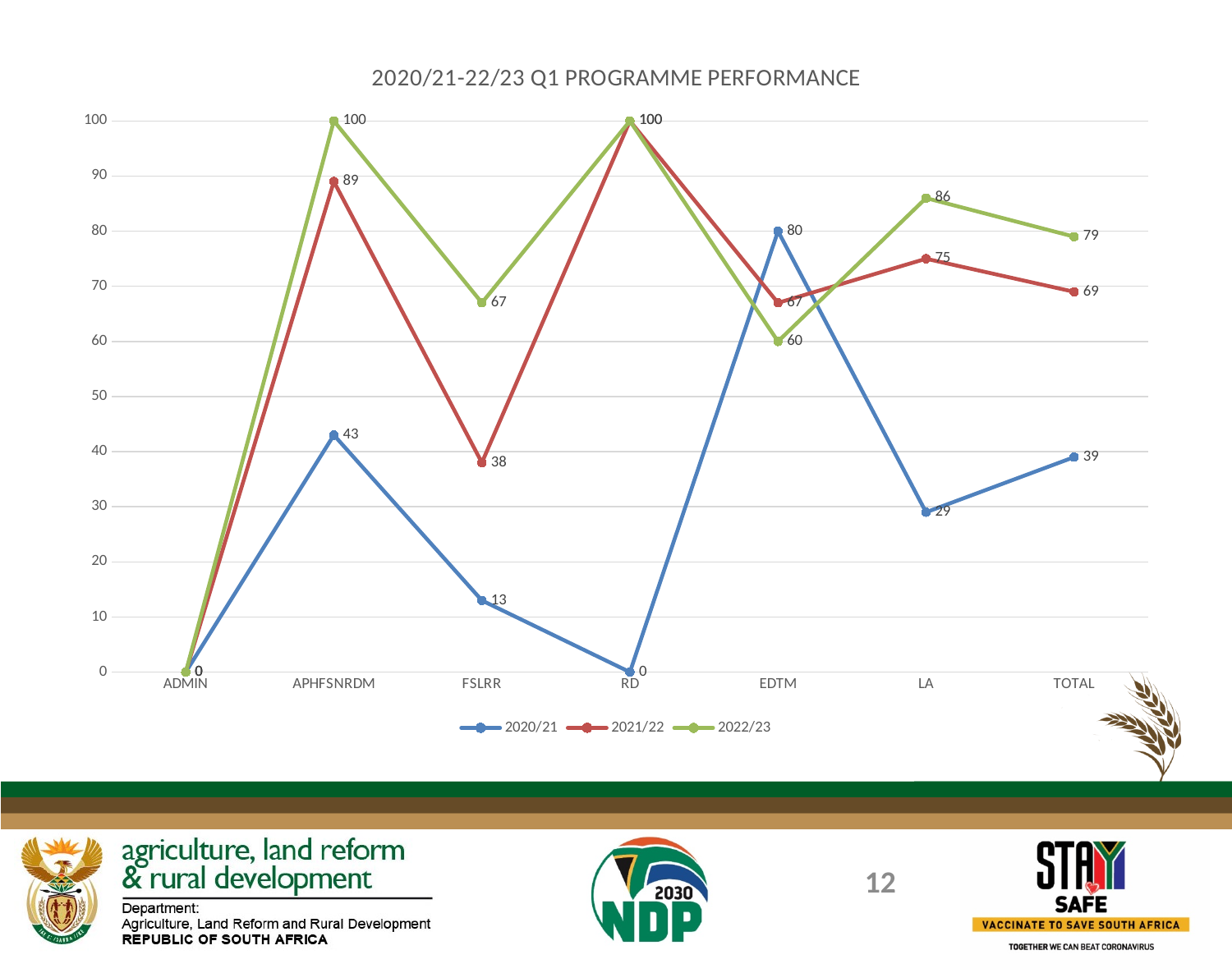
What is the title of the chart? 2020/21-22/23 Q1 PROGRAMME PERFORMANCE Which category has the highest 2020/21 value? EDTM For EDTM, which series has the larger value, 2020/21 or 2022/23? 2020/21 What is the 2020/21 value for EDTM? 80 How many series does the legend list? 3 What is the 2020/21 value for TOTAL? 39 What kind of chart is shown on the slide? Line chart How many categories are shown on the x axis? 7 What is the 2021/22 value for FSLRR? 38 What is the difference between the 2022/23 and 2021/22 values for TOTAL? 10 Which category has the lowest 2022/23 value? ADMIN What is the 2022/23 value for LA? 86